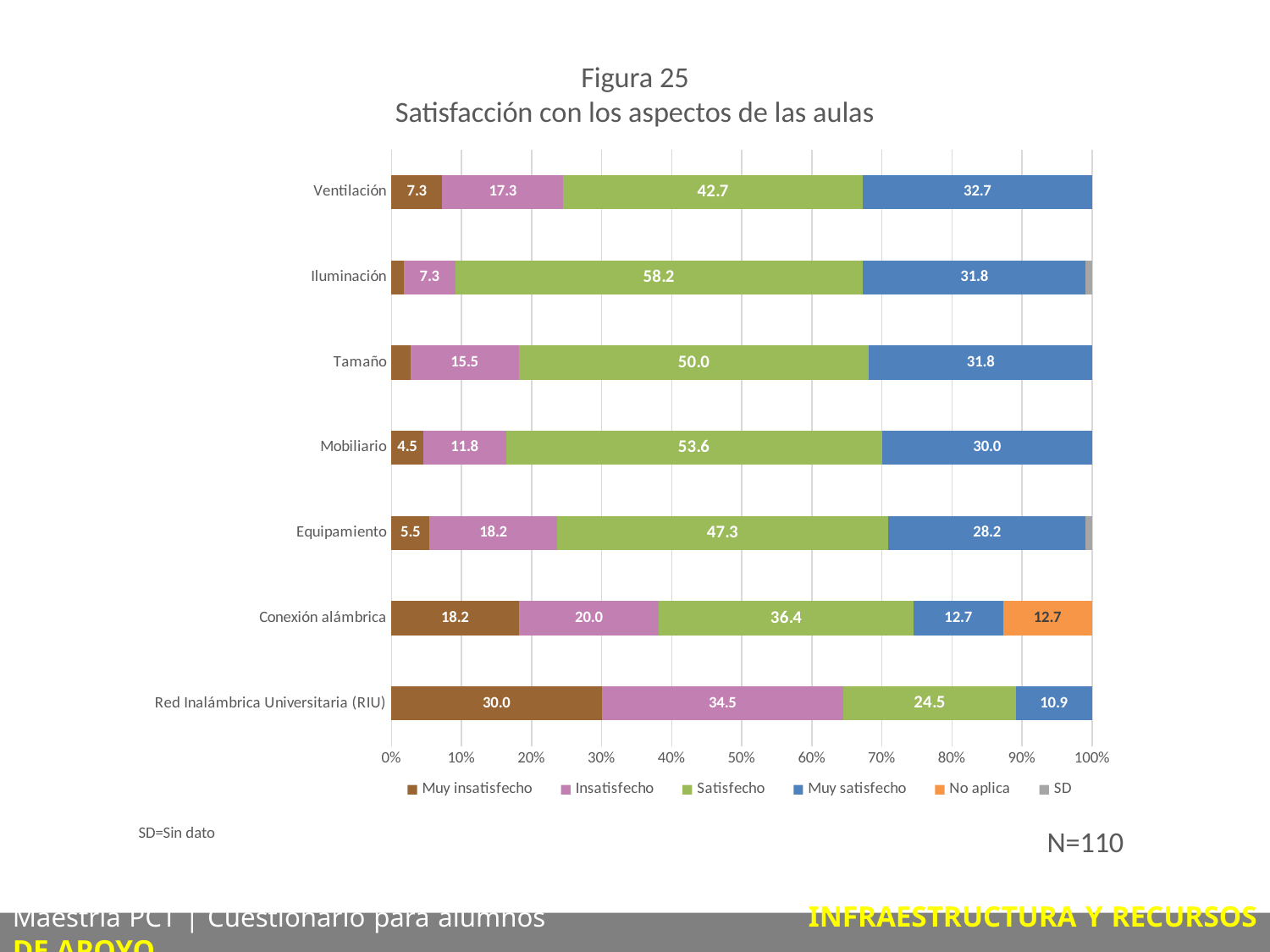
According to the note on the slide, what does SD stand for? Sin dato Which category has the lowest Muy satisfecho value? Red Inalámbrica Universitaria (RIU) What is the No aplica value for Conexión alámbrica? 12.7 What is the Muy insatisfecho value for Red Inalámbrica Universitaria (RIU)? 30.0 How many series does the legend list? 6 Which category has the highest Satisfecho value? Iluminación Which category has the highest Muy insatisfecho value? Red Inalámbrica Universitaria (RIU) For Ventilación, what is the difference between the Satisfecho value and the Muy satisfecho value? 10.0 Which has a larger Insatisfecho value, Conexión alámbrica or Equipamiento? Conexión alámbrica What is the Satisfecho value for Iluminación? 58.2 What kind of chart is shown on the slide? Stacked horizontal bar chart How many aspects of the classrooms (categories) are plotted in the chart? 7